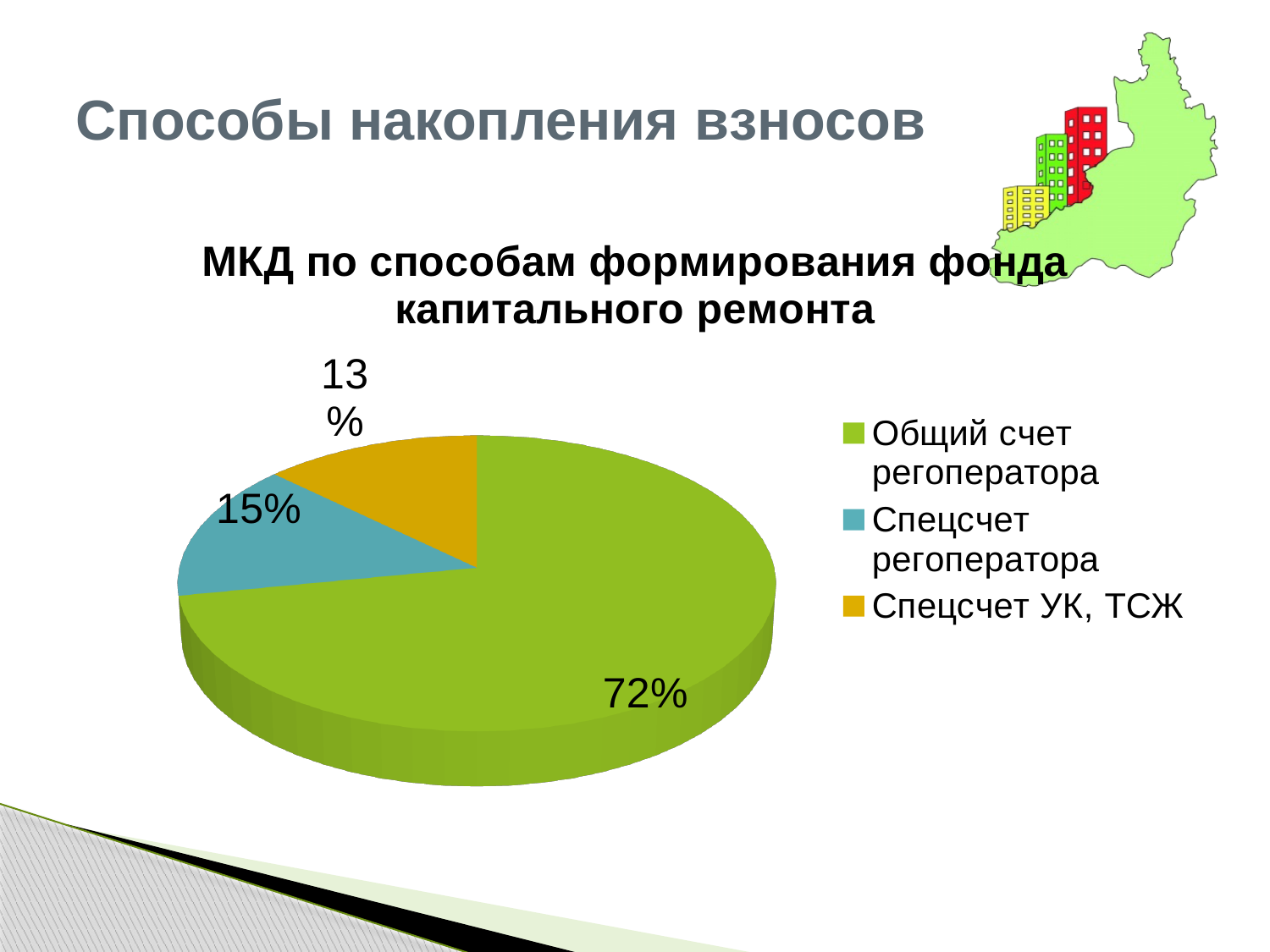
What is the difference between the shares of "Общий счет регоператора" and "Спецсчет регоператора"? 57% How many slices does the pie chart have? 3 What share of the pie does "Спецсчет регоператора" have? 15% Which category has the smallest slice of the pie? Спецсчет УК, ТСЖ What share of the pie does "Спецсчет УК, ТСЖ" have? 13% How many categories does the legend list? 3 What colour is the slice for "Спецсчет регоператора"? blue Which is larger: the share of "Спецсчет регоператора" or "Спецсчет УК, ТСЖ"? Спецсчет регоператора What is the title of the chart? МКД по способам формирования фонда капитального ремонта What kind of chart is shown on the slide? pie chart Which category has the largest slice of the pie? Общий счет регоператора What share of the pie does "Общий счет регоператора" have? 72%